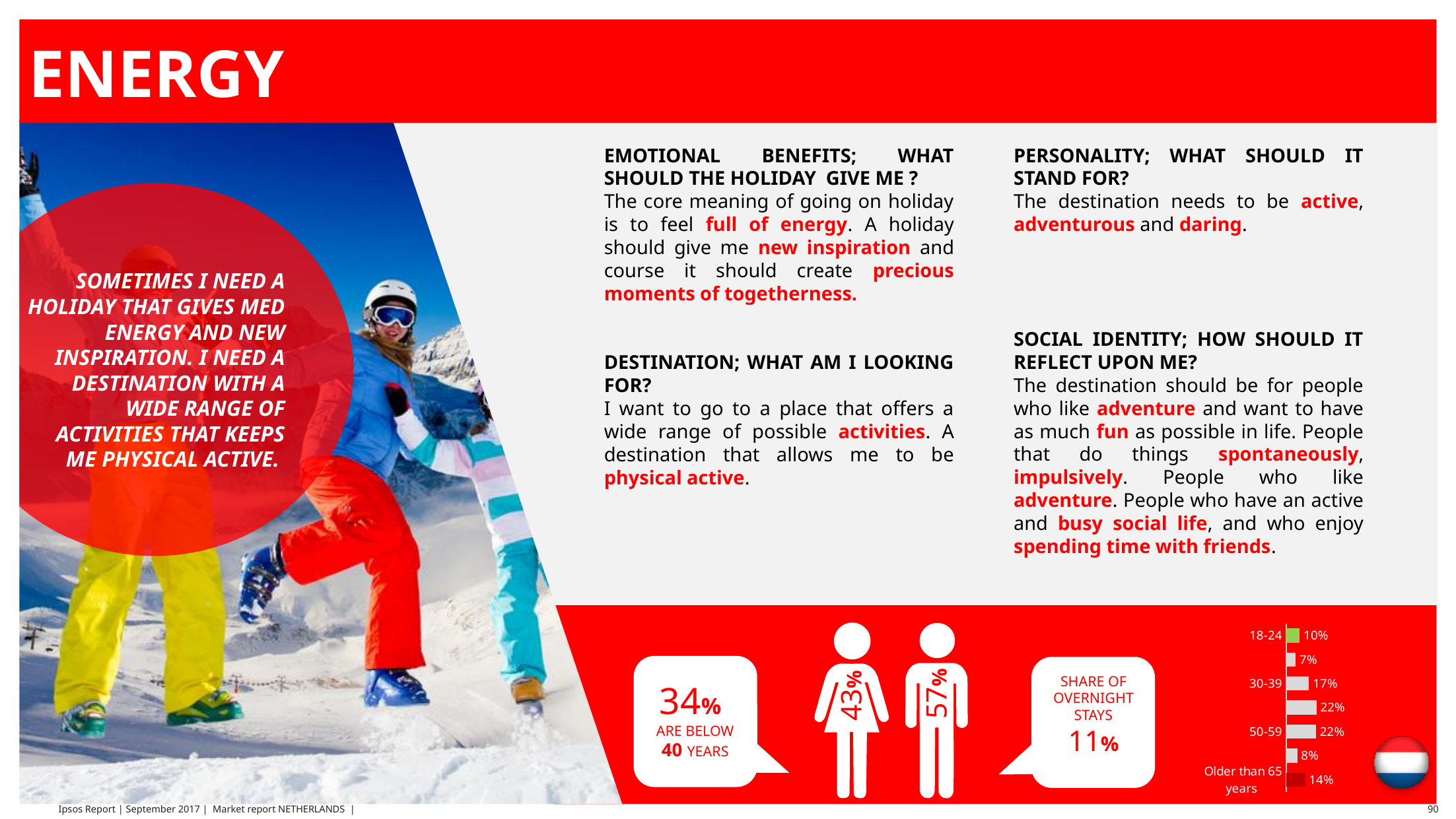
In the bar chart at the bottom right, which is larger: the value for 50-59 or the value for 30-39? 50-59 In the bar chart at the bottom right, what is the difference between the values for 50-59 and 18-24? 12 percentage points In the bar chart at the bottom right, what colour is the bar for the 'Older than 65 years' group? Dark red In the bar chart at the bottom right, what is the difference between the values for 30-39 and 'Older than 65 years'? 3 percentage points In the bar chart at the bottom right, what is the value for the 50-59 age group? 22% How many bars are plotted in the bar chart at the bottom right? 7 In the bar chart at the bottom right, what is the value for the 30-39 age group? 17% In the bar chart at the bottom right, what is the value for the 18-24 age group? 10% In the bar chart at the bottom right, what is the value for the 'Older than 65 years' group? 14% What kind of chart is shown at the bottom right of the slide? Bar chart In the bar chart at the bottom right, which is larger: the value for 18-24 or the value for 'Older than 65 years'? Older than 65 years In the bar chart at the bottom right, what colour is the bar for the 18-24 age group? Green